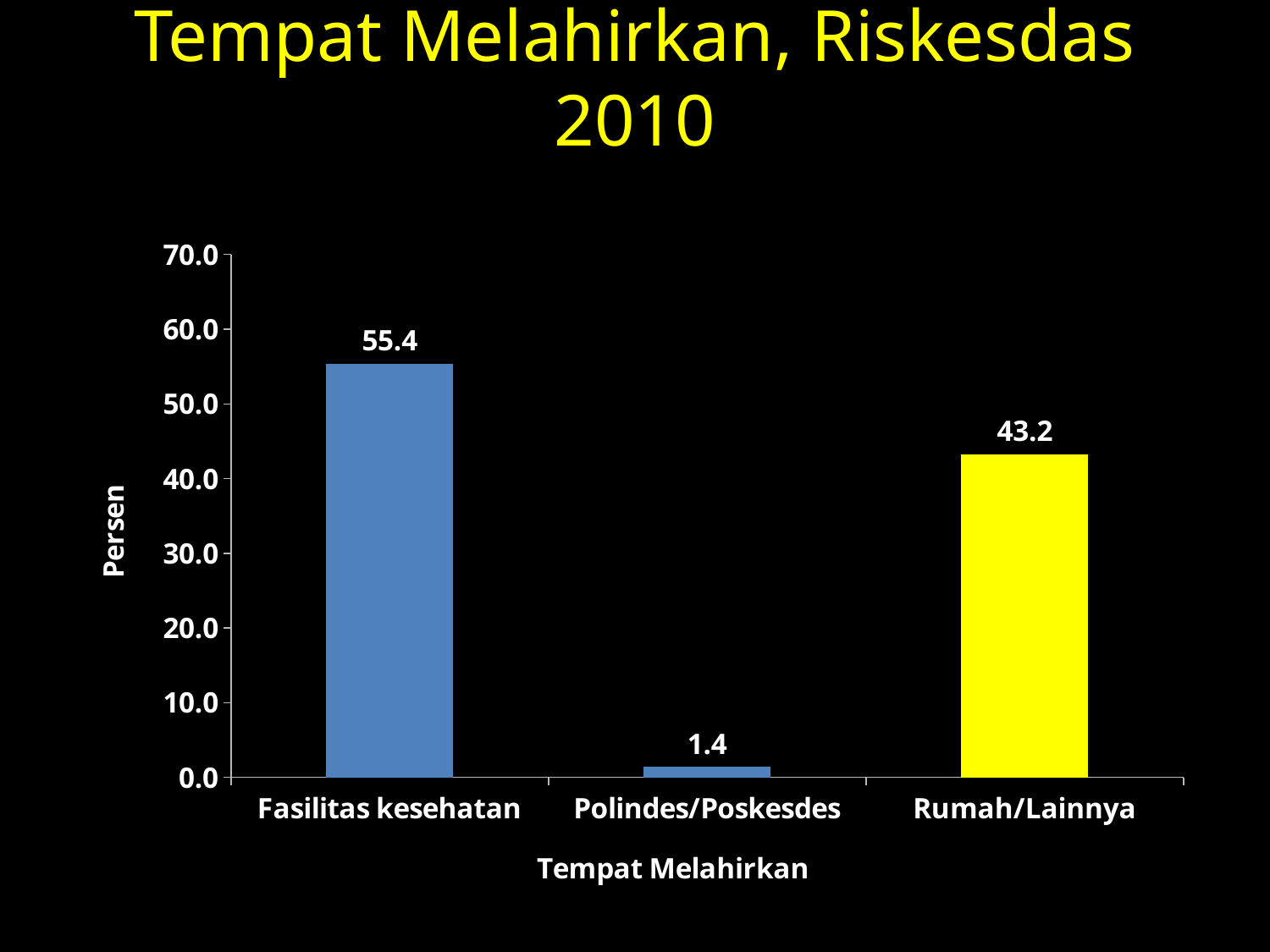
What is the value for Fasilitas kesehatan? 55.4 What is the difference between the values for Fasilitas kesehatan and Rumah/Lainnya? 12.2 What is the label of the y axis? Persen Which is larger, the value for Rumah/Lainnya or the value for Polindes/Poskesdes? Rumah/Lainnya What is the value for Polindes/Poskesdes? 1.4 What is the value for Rumah/Lainnya? 43.2 Which category has the highest value? Fasilitas kesehatan What is the difference between the values for Rumah/Lainnya and Polindes/Poskesdes? 41.8 Which category has the lowest value? Polindes/Poskesdes What kind of chart is shown on the slide? bar chart Is the value for Rumah/Lainnya greater or less than 40.0? greater How many categories are shown on the x axis? 3